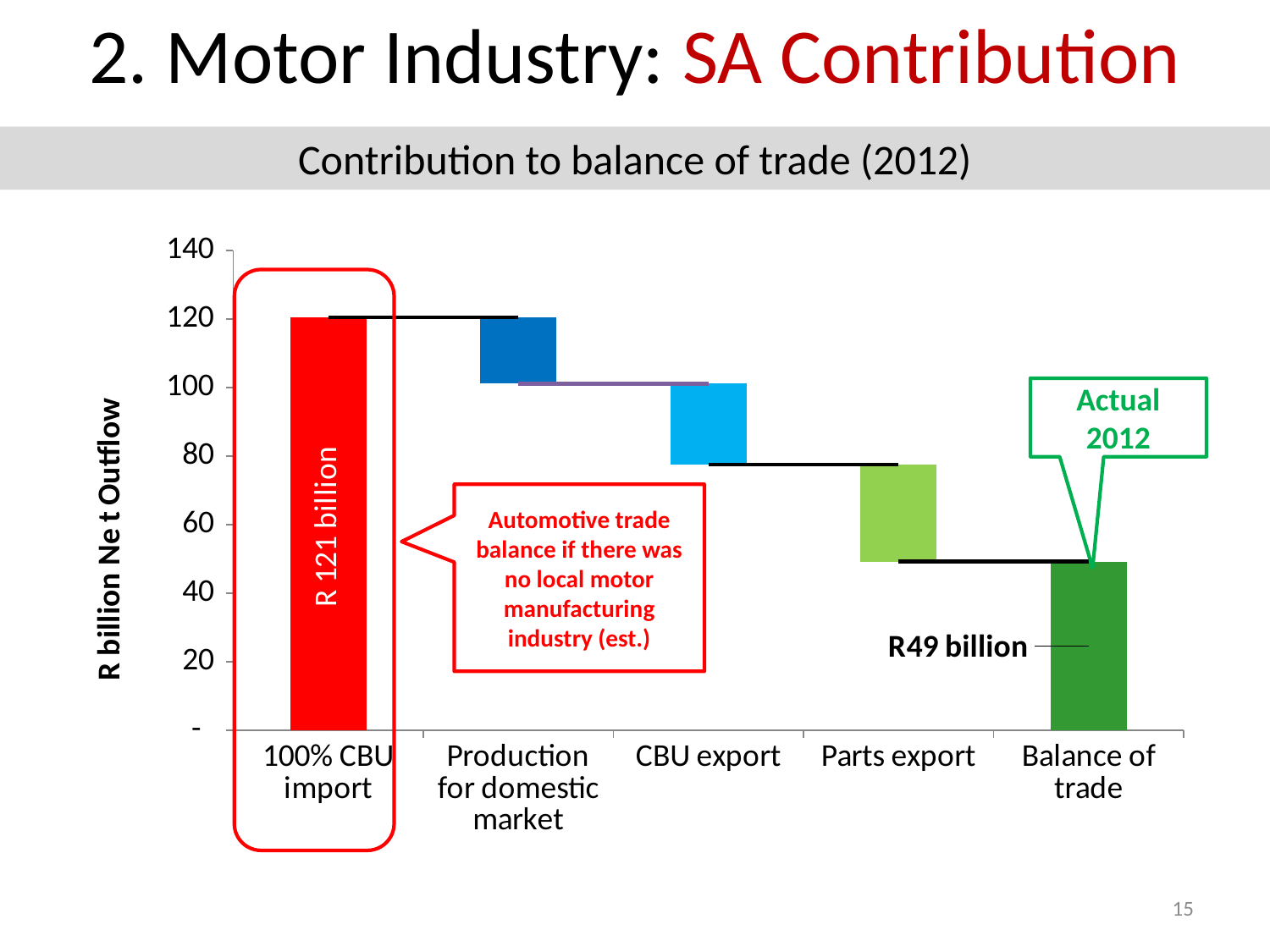
What kind of chart is shown on the slide? bar chart Which category has the highest bar? 100% CBU import Is the value for Balance of trade greater or less than 60? less What is the title of the chart? Contribution to balance of trade (2012) Do the cumulative levels rise or fall from left to right across the chart? fall What is the label on the y axis? R billion Net Outflow What is the difference between the 100% CBU import value and the Balance of trade value? R72 billion Which is larger, the value for 100% CBU import or the value for Balance of trade? 100% CBU import Is the value for 100% CBU import greater or less than 100? greater What is the value for 100% CBU import? R 121 billion How many categories are shown on the x axis? 5 What is the value for Balance of trade? R49 billion